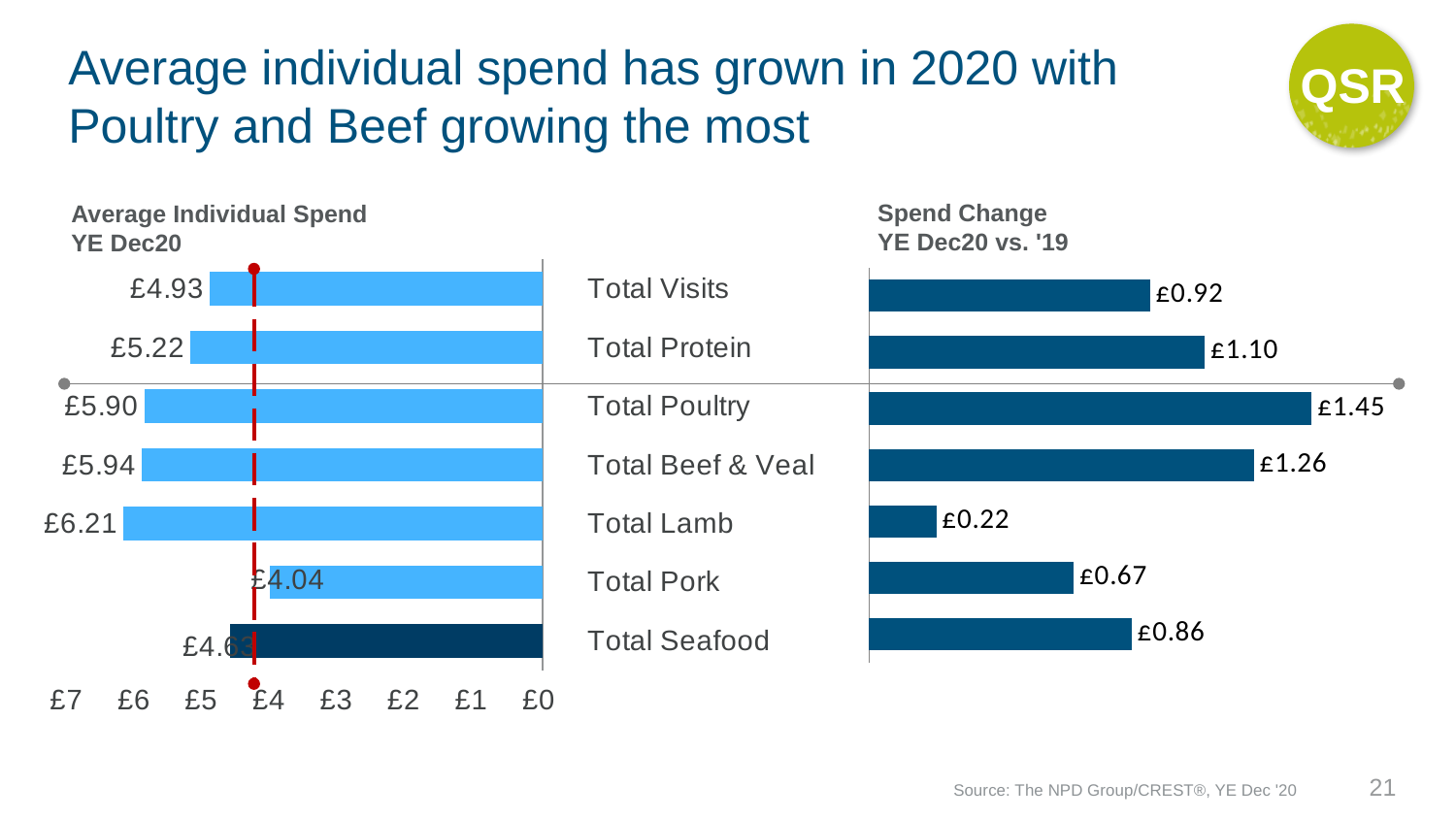
In the Spend Change YE Dec20 vs. '19 chart, what is the difference between Total Poultry and Total Beef & Veal? £0.19 In the Spend Change YE Dec20 vs. '19 chart, which category has the lowest value? Total Lamb In the Spend Change YE Dec20 vs. '19 chart, which is larger: Total Protein or Total Visits? Total Protein In the Spend Change YE Dec20 vs. '19 chart, what is the value for Total Seafood? £0.86 In the Spend Change YE Dec20 vs. '19 chart, which category has the highest value? Total Poultry In the Average Individual Spend YE Dec20 chart, what is the difference between Total Lamb and Total Pork? £2.17 In the Spend Change YE Dec20 vs. '19 chart, what is the value for Total Poultry? £1.45 What kind of chart is the Average Individual Spend YE Dec20 chart? Bar chart In the Average Individual Spend YE Dec20 chart, what is the value for Total Lamb? £6.21 In the Average Individual Spend YE Dec20 chart, what is the value for Total Pork? £4.04 In the Average Individual Spend YE Dec20 chart, which category has the highest value? Total Lamb How many categories are shown in the Spend Change YE Dec20 vs. '19 chart? 7